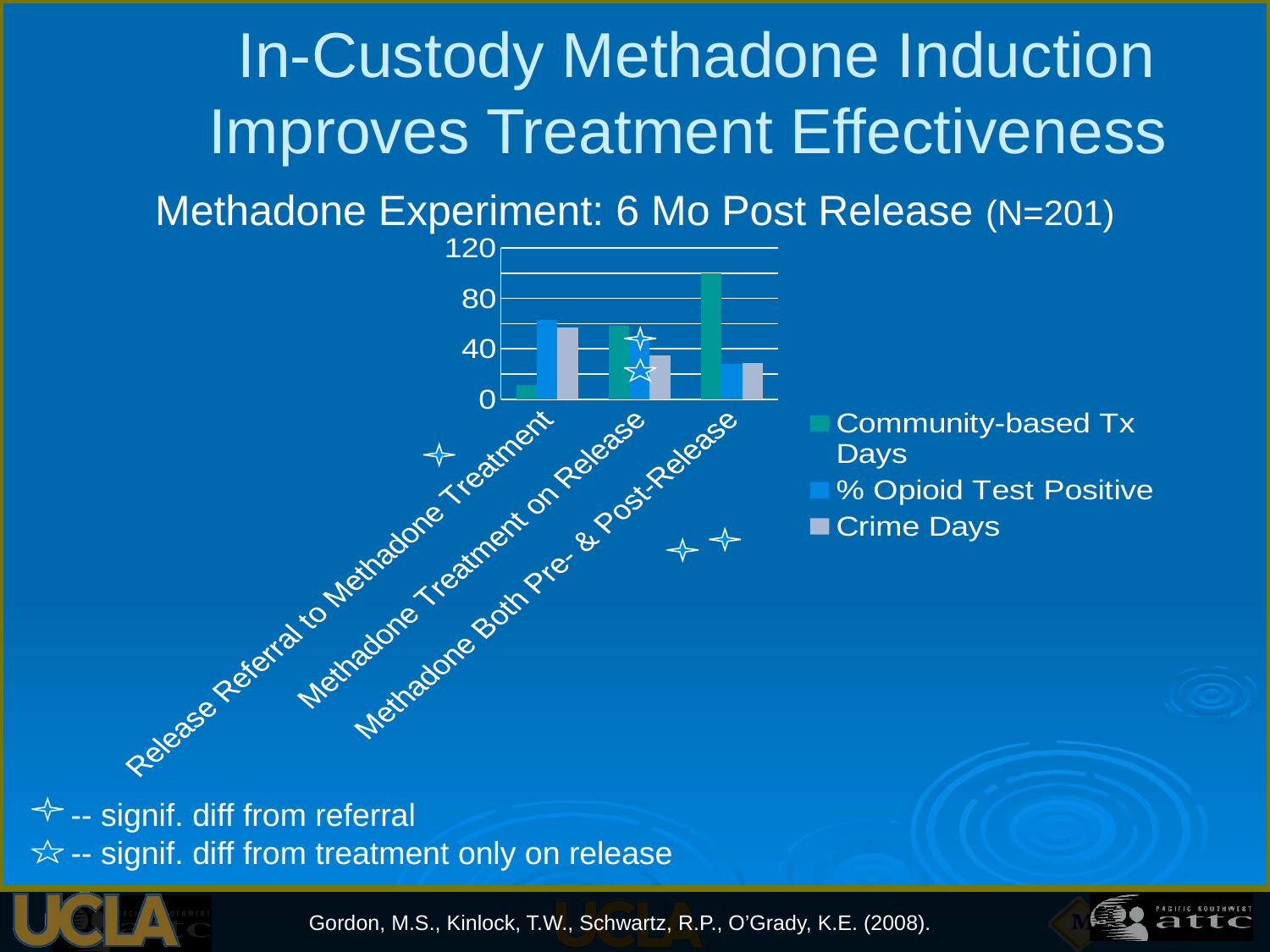
How many categories are shown along the x axis of the chart? 3 Which category has the lowest value for Community-based Tx Days? Release Referral to Methadone Treatment How many series does the chart's legend list? 3 Is the value for % Opioid Test Positive in the Release Referral to Methadone Treatment category greater or less than 40? greater Is the value for Community-based Tx Days in the Methadone Both Pre- & Post-Release category greater or less than 80? greater Do the Community-based Tx Days values rise or fall moving from Release Referral to Methadone Treatment to Methadone Both Pre- & Post-Release? Rise Which category has the highest value for Community-based Tx Days? Methadone Both Pre- & Post-Release Is the value for Crime Days in the Methadone Both Pre- & Post-Release category greater or less than 40? less What kind of chart is shown on the slide? Bar chart What is the title of the chart? Methadone Experiment: 6 Mo Post Release (N=201) In the Methadone Both Pre- & Post-Release category, which is larger: Community-based Tx Days or Crime Days? Community-based Tx Days